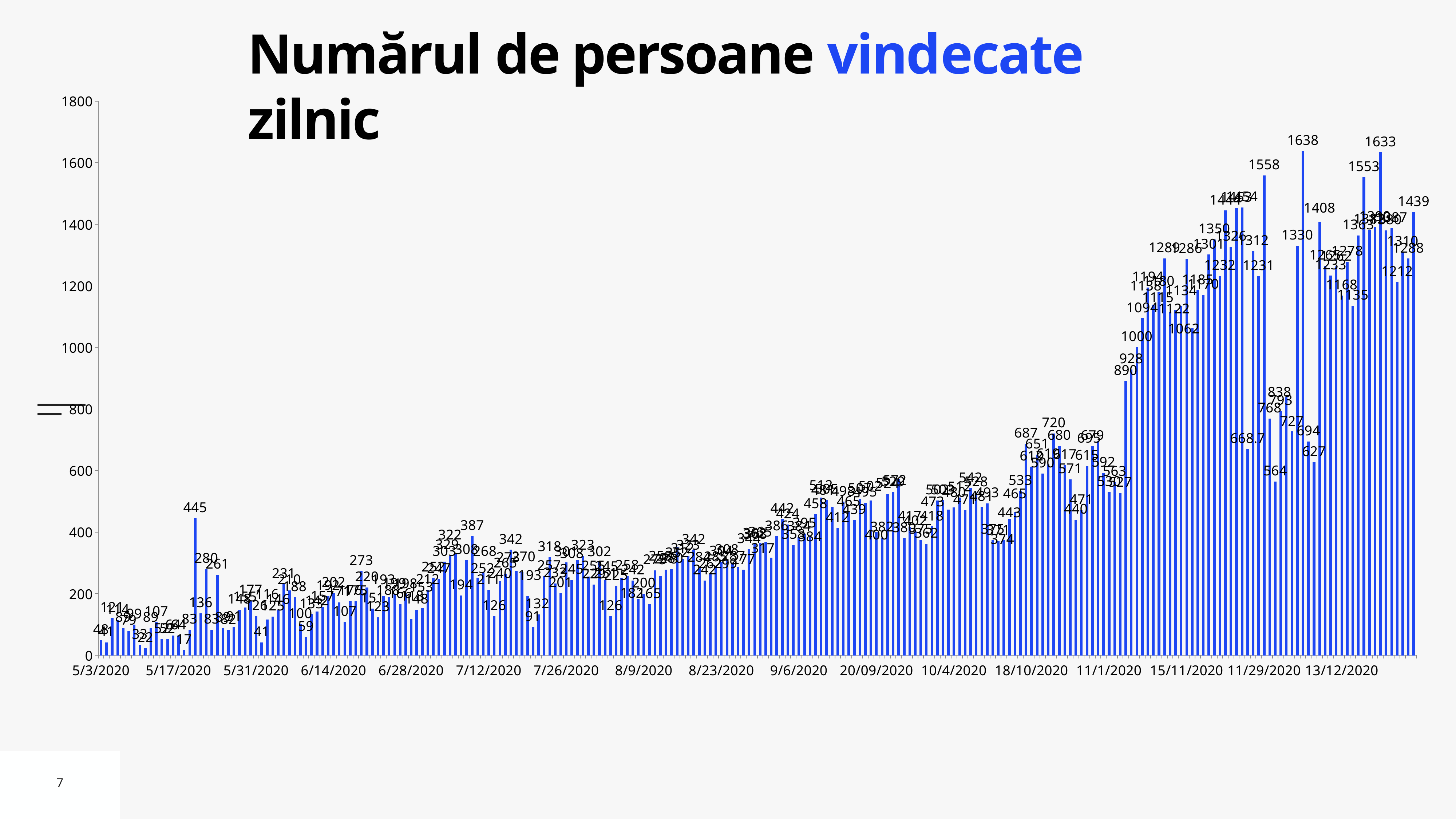
Do the daily values generally rise or fall from left to right along the x axis? rise Is the value for 5/3/2020 greater or less than 200? less What kind of chart is shown on the slide? bar chart Which is larger, the bar labelled 445 in May or the bar labelled 387 in July? 445 What is the value of the second-tallest bar in the chart? 1633 Is the value of the rightmost bar greater or less than 1400? greater What is the value of the rightmost (last) bar in the chart? 1439 What is the highest tick value shown on the y axis? 1800 What is the title of the chart? Numărul de persoane vindecate zilnic What is the value of the tallest bar in the chart? 1638 What is the difference between the two tallest bars, labelled 1638 and 1633? 5 Is the value for 7/12/2020 greater or less than 600? less